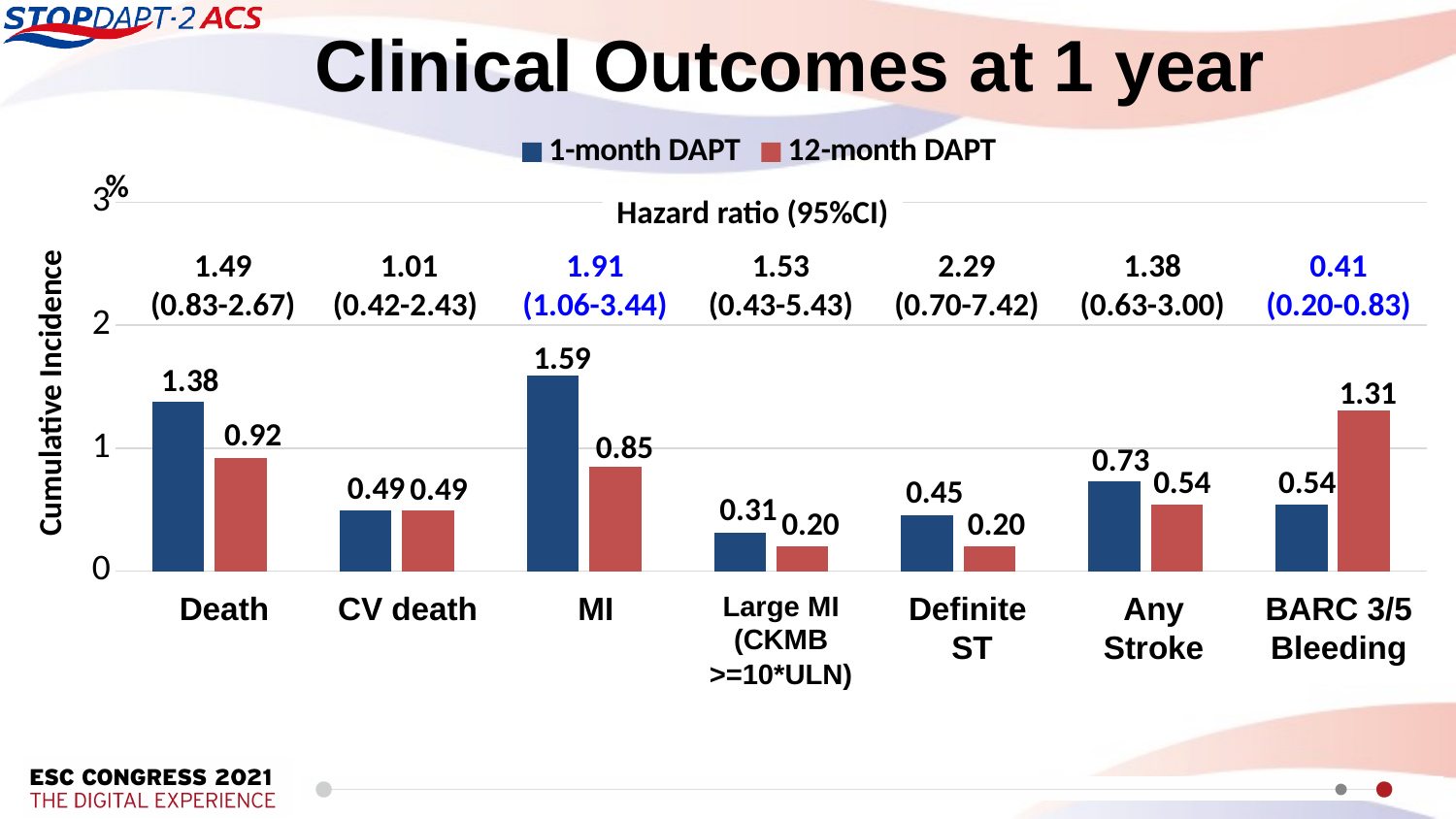
What is the hazard ratio (95% CI) shown for BARC 3/5 Bleeding? 0.41 (0.20-0.83) For BARC 3/5 Bleeding, which group has the higher cumulative incidence, 1-month DAPT or 12-month DAPT? 12-month DAPT What is the hazard ratio (95% CI) shown for Definite ST? 2.29 (0.70-7.42) What is the difference between the 1-month DAPT and 12-month DAPT cumulative incidence for MI? 0.74 Which outcome has the lowest cumulative incidence in the 12-month DAPT group? Large MI (CKMB >=10*ULN) and Definite ST (both 0.20) Which outcome has the highest cumulative incidence in the 1-month DAPT group? MI What is the cumulative incidence of MI in the 12-month DAPT group? 0.85 How many outcome categories are shown on the x axis? 7 What is the cumulative incidence of Death in the 1-month DAPT group? 1.38 What kind of chart is shown on the slide? Bar chart How many series does the legend list? 2 What is the cumulative incidence of BARC 3/5 Bleeding in the 12-month DAPT group? 1.31